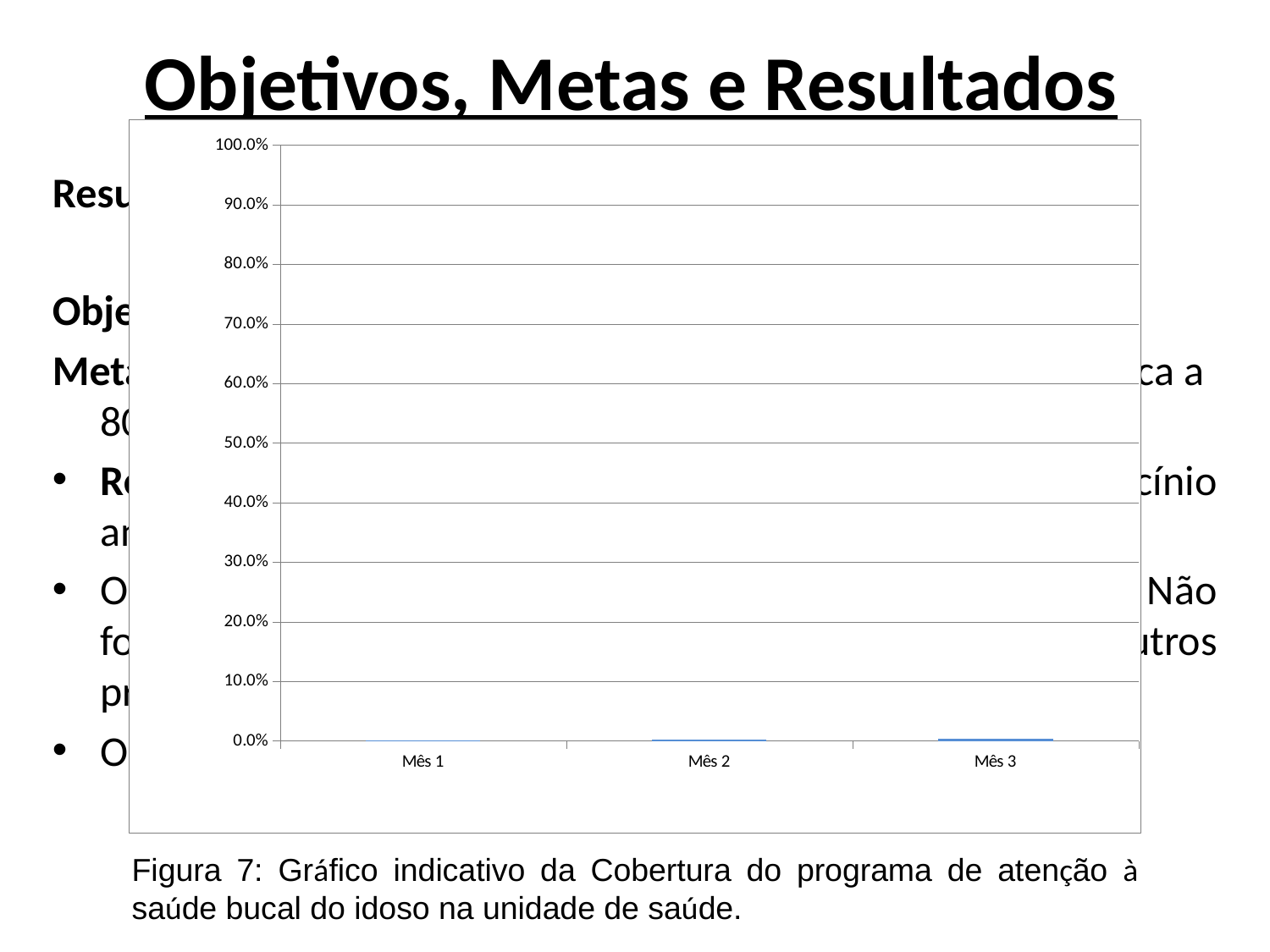
What is the highest value shown on the y axis of the chart? 100.0% Is the value for Mês 3 greater or less than 50.0%? less What is the label of the first category on the x axis? Mês 1 What kind of chart is shown on the slide? bar chart Is the value for Mês 2 greater or less than 10.0%? less Is the value for Mês 1 greater or less than 10.0%? less How many categories are shown on the x axis of the chart? 3